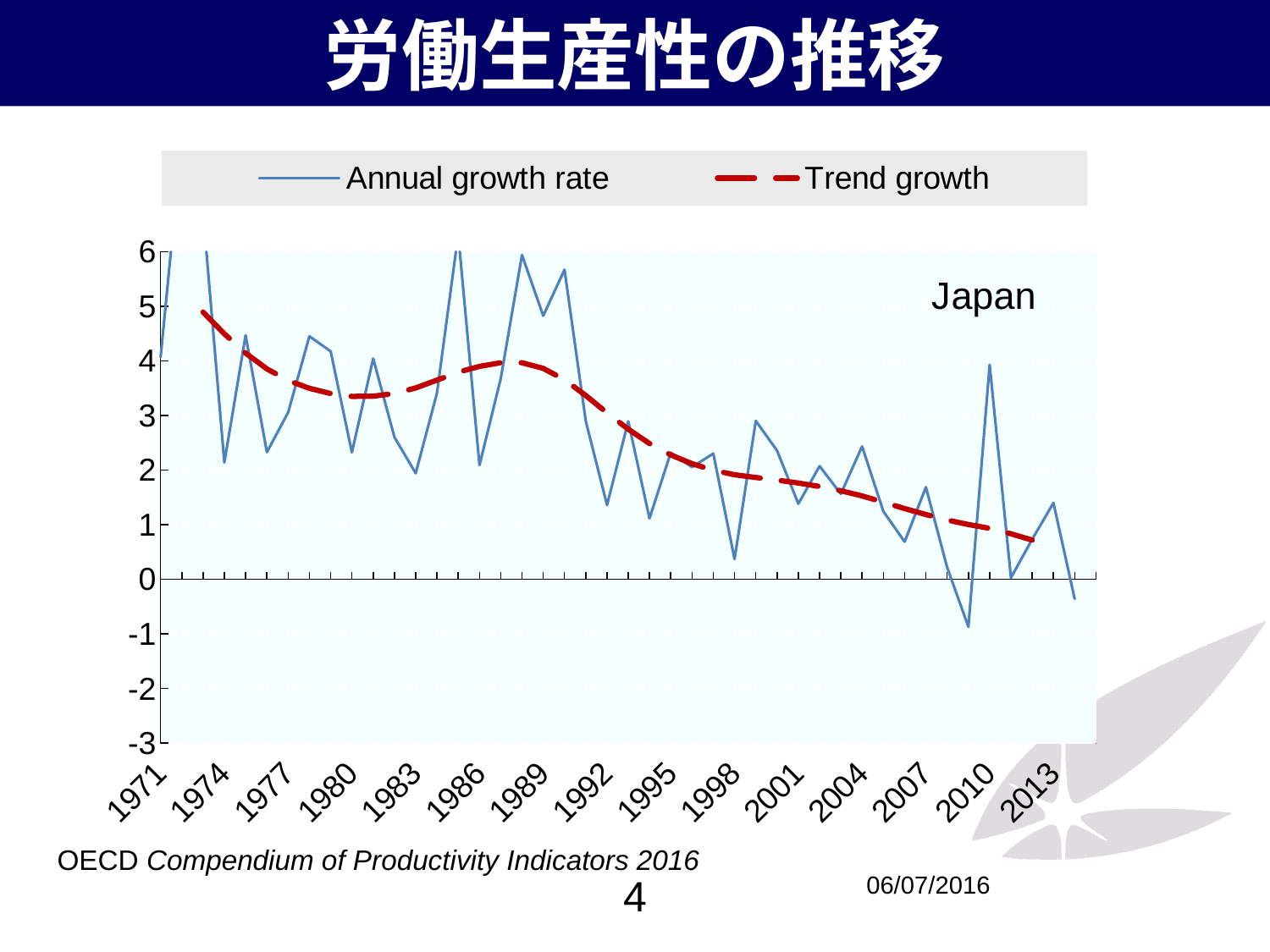
Is the Trend growth value for 2001 greater or less than 3? less Does the Trend growth line rise or fall overall from 1971 to 2013? fall How many year labels are shown along the x axis? 15 Which is larger, the Trend growth value for 1974 or for 2010? 1974 Is the Annual growth rate for 1971 greater or less than 3? greater Which series is drawn as a red dashed line? Trend growth Is the Annual growth rate for 2013 greater or less than 0? greater How many series does the legend list? 2 Which country is the chart labelled as showing? Japan What kind of chart is shown on the slide? line chart